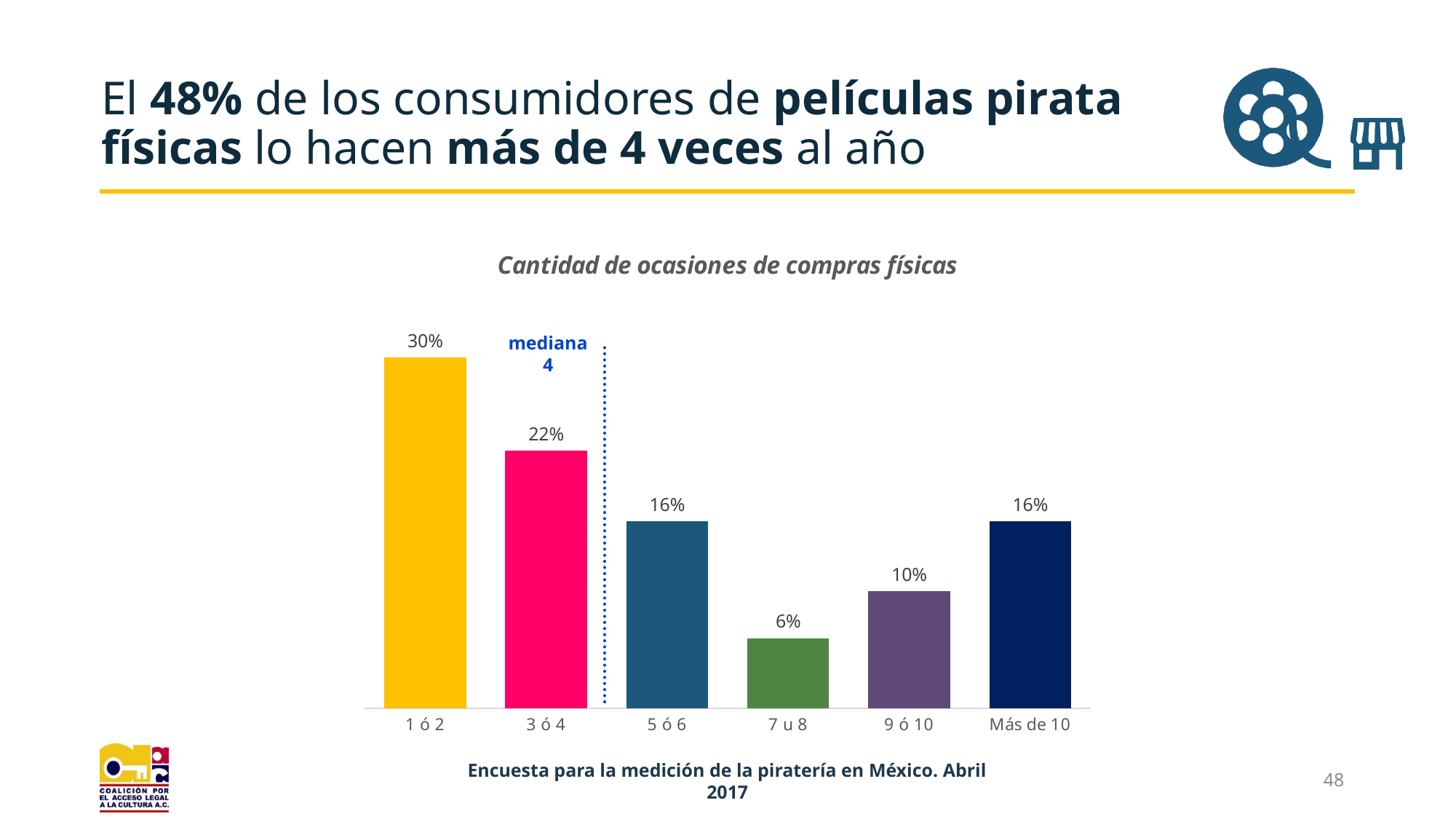
What is the value for the "Más de 10" category? 16% Which category has the lowest value? 7 u 8 How many categories are shown on the x axis? 6 Which is larger, the value for "9 ó 10" or the value for "Más de 10"? Más de 10 What is the difference between the values for "1 ó 2" and "3 ó 4"? 8% What median value is marked by the dotted line on the chart? 4 Which category has the highest value? 1 ó 2 What is the value for the "1 ó 2" category? 30% What is the title of the chart? Cantidad de ocasiones de compras físicas What kind of chart is shown on the slide? Bar chart What is the value for the "7 u 8" category? 6% What is the value for the "3 ó 4" category? 22%